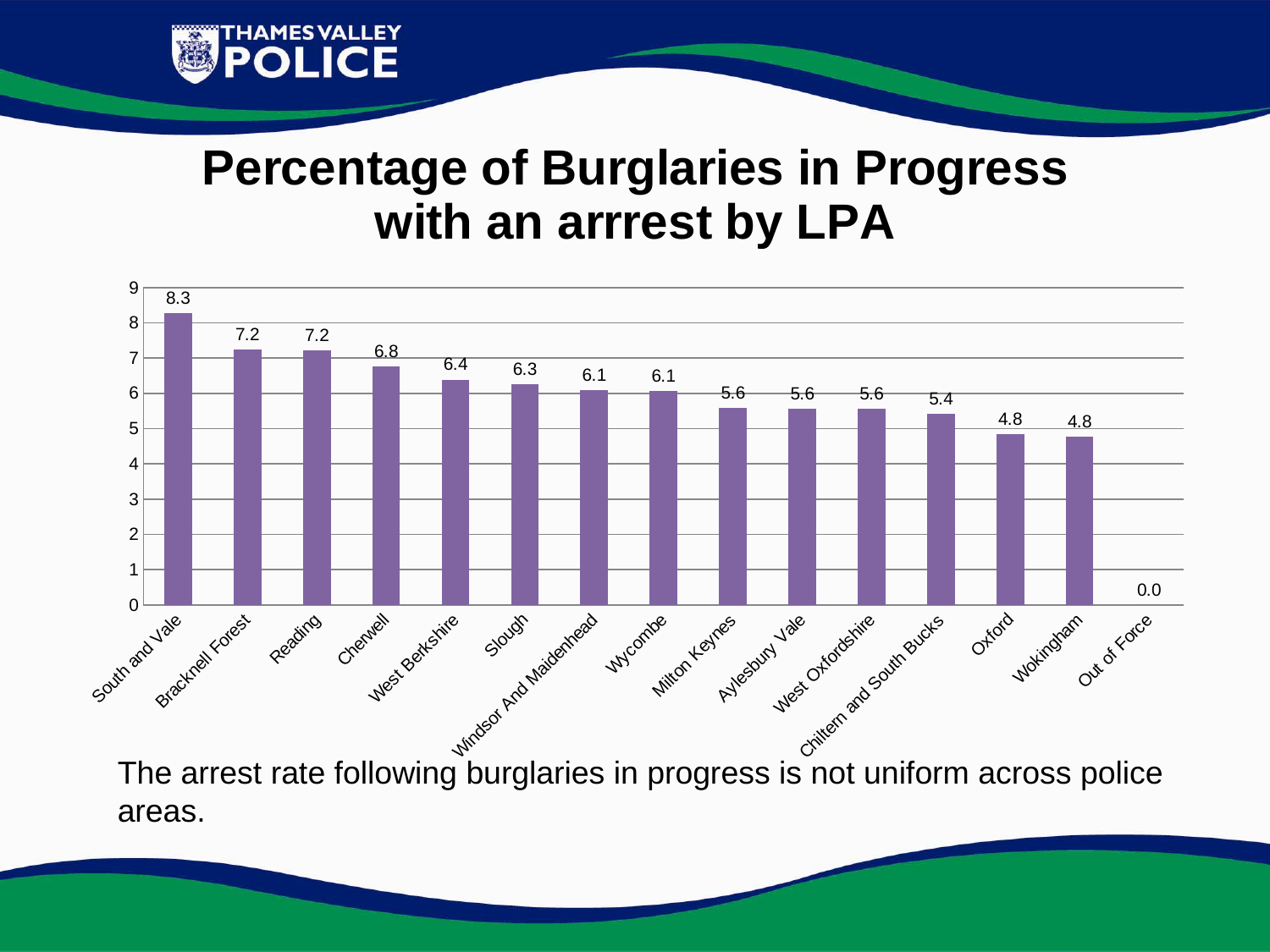
Which is larger, the value for Bracknell Forest or the value for West Berkshire? Bracknell Forest Which category has the highest value? South and Vale What kind of chart is shown on the slide? Bar chart What is the value for Chiltern and South Bucks? 5.4 What is the difference between the values for Cherwell and Slough? 0.5 Do the values generally rise or fall from left to right along the x axis? Fall What is the value for Out of Force? 0.0 How many categories are shown on the x axis? 15 What is the value for South and Vale? 8.3 What is the difference between the values for South and Vale and Oxford? 3.5 What is the value for Cherwell? 6.8 Which category has the lowest value? Out of Force